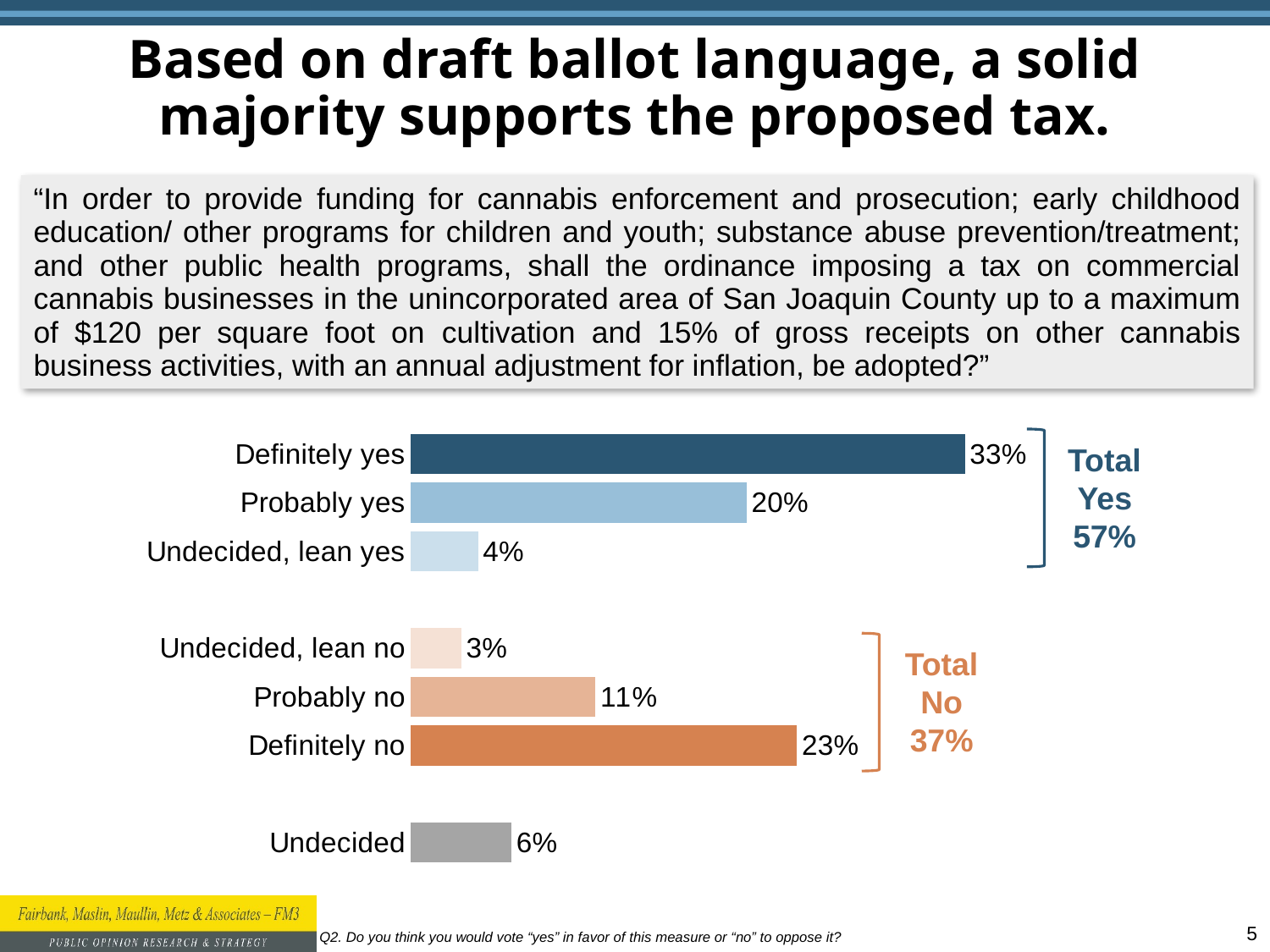
What is the Total Yes percentage shown on the chart? 57% Which is larger, "Probably yes" or "Probably no"? Probably yes What percentage of respondents said "Definitely yes"? 33% How many response categories are shown in the chart? 7 What colour are the bars for the "no" responses? Orange What is the value for "Undecided"? 6% What is the Total No percentage shown on the chart? 37% What is the difference between "Definitely yes" and "Definitely no"? 10% Which response category has the highest value? Definitely yes What percentage of respondents said "Probably no"? 11% Which response category has the lowest value? Undecided, lean no What kind of chart is shown on the slide? Bar chart